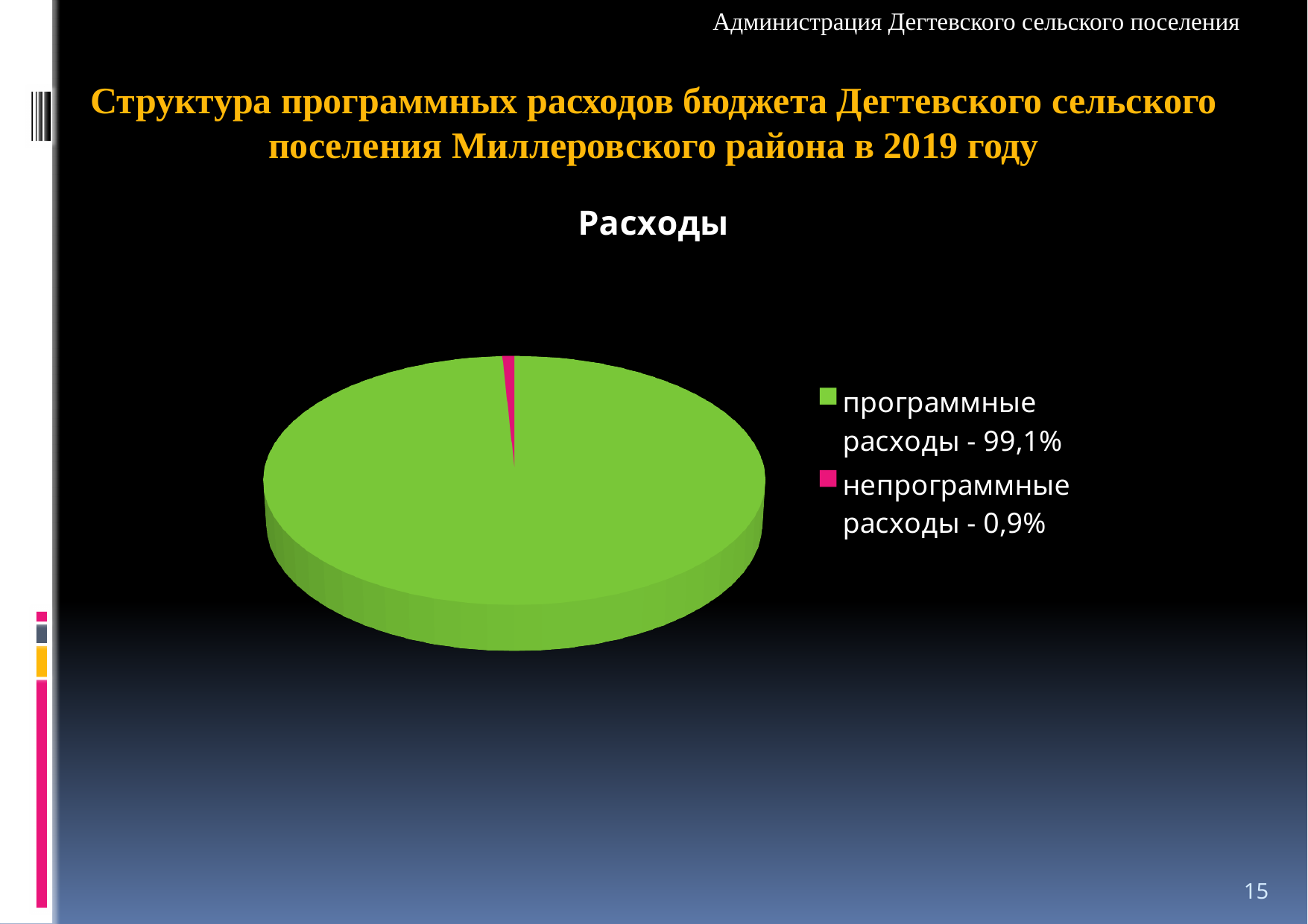
What colour is the slice for непрограммные расходы? pink Which category has the largest share of the pie? программные расходы What share of expenditures is shown for непрограммные расходы? 0,9% What is the title of the chart? Расходы What kind of chart is shown on the slide? pie chart Which category has the smallest share of the pie? непрограммные расходы How many categories does the pie chart show? 2 What share of expenditures is shown for программные расходы? 99,1% Which is larger: the share for программные расходы or for непрограммные расходы? программные расходы What is the total of the two shares shown in the pie chart? 100% What is the difference in percentage points between программные расходы and непрограммные расходы? 98,2